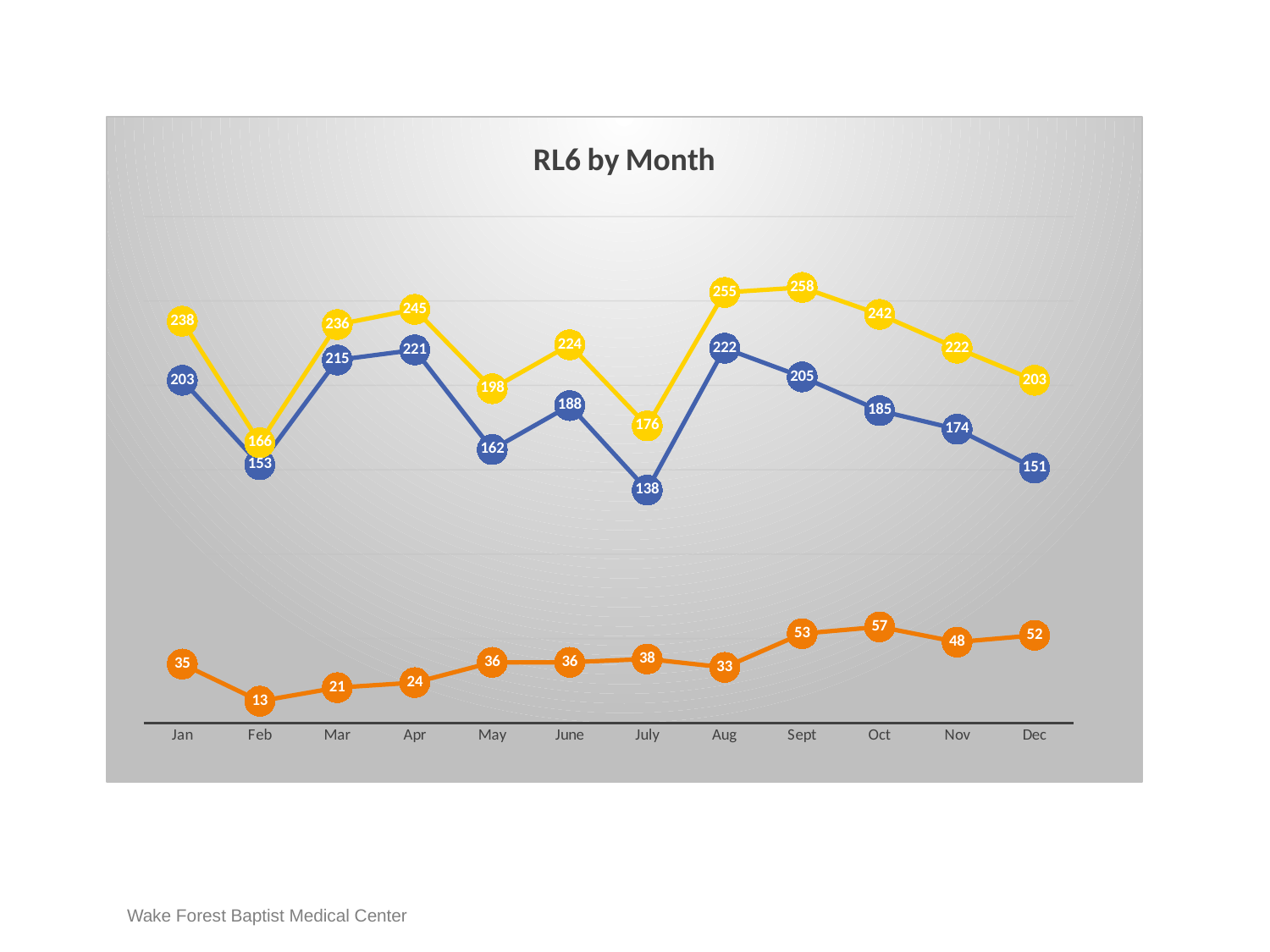
What is the difference between the yellow line and the blue line in Aug? 33 In which month does the orange line have its lowest value? Feb What is the value of the yellow line in Sept? 258 What is the title of the chart? RL6 by Month What is the value of the orange line in Oct? 57 Which is larger for the blue line: the value in Mar or the value in Nov? Mar In which month does the yellow line reach its highest value? Sept What is the value of the blue line in July? 138 How many months are shown on the x axis? 12 What kind of chart is shown on the slide? line chart In which month does the blue line have its lowest value? July Does the blue line rise or fall from Sept to Dec? fall